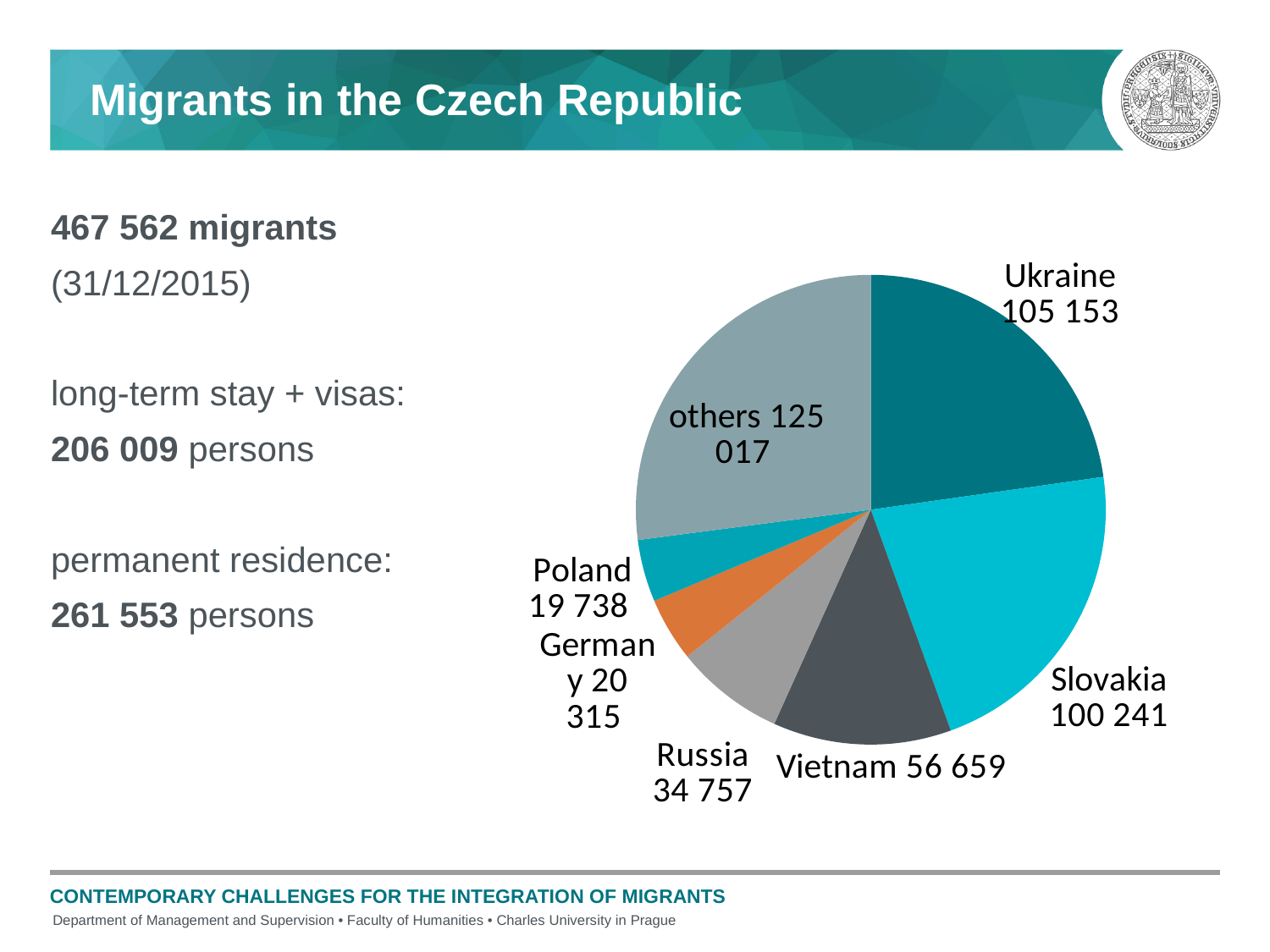
What is the value shown for Slovakia in the pie chart? 100 241 What is the value shown for Vietnam in the pie chart? 56 659 What is the value shown for Ukraine in the pie chart? 105 153 What type of chart is shown on the slide? Pie chart What is the difference between the values for Vietnam and Russia in the pie chart? 21 902 What is the difference between the values for Ukraine and Slovakia in the pie chart? 4 912 Which named country in the pie chart has the smallest value? Poland What is the value shown for the 'others' slice in the pie chart? 125 017 What is the value shown for Russia in the pie chart? 34 757 Which slice of the pie chart has the largest value? others How many slices does the pie chart have? 7 Which has a larger value in the pie chart, Germany or Poland? Germany